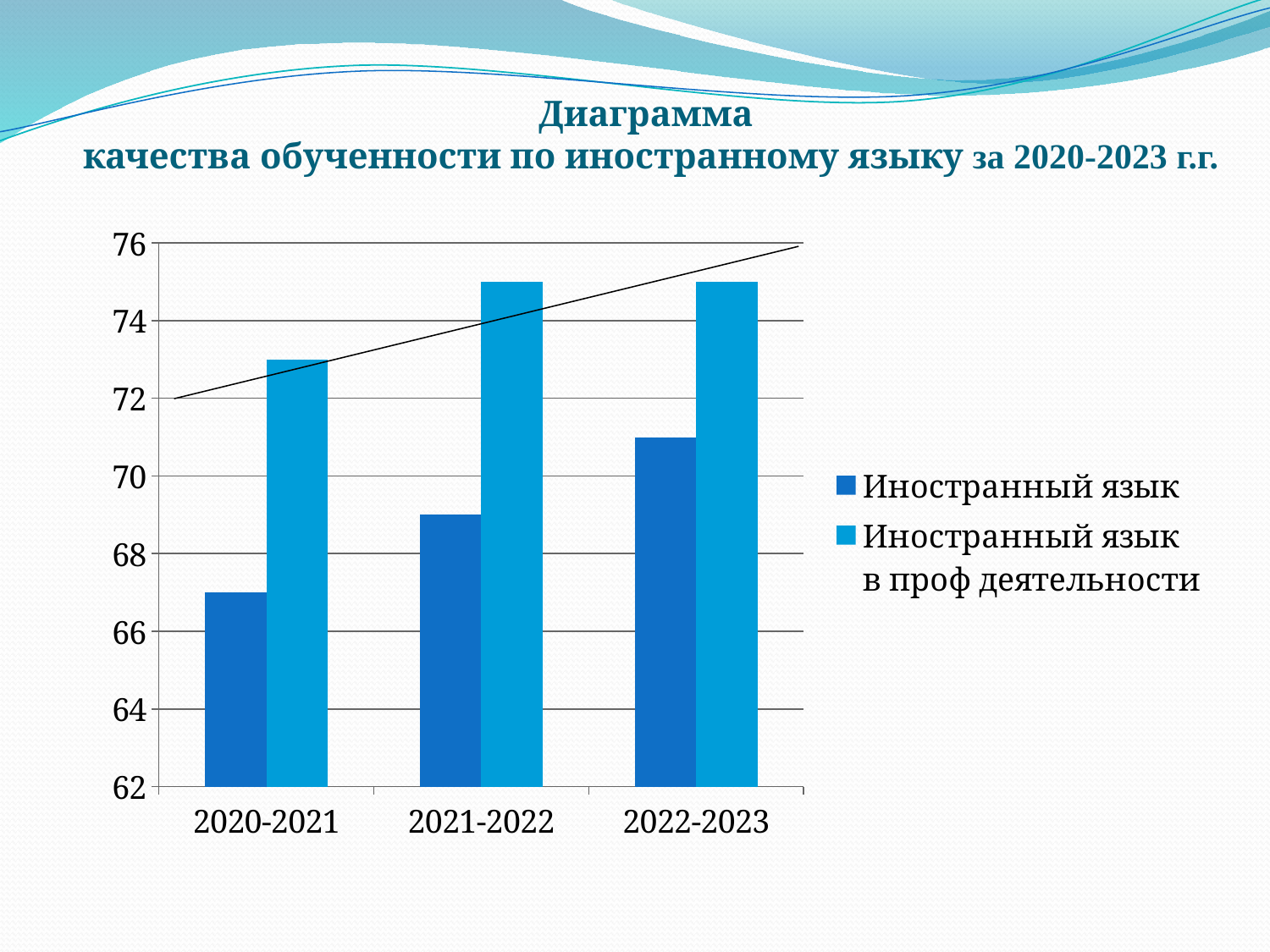
Is the value for Иностранный язык в проф деятельности in 2021-2022 greater or less than 74? greater What kind of chart is shown on the slide? bar chart Is the value for Иностранный язык in 2020-2021 greater or less than 68? less In which academic year is the value for Иностранный язык the lowest? 2020-2021 Which series is shown in the darker blue colour? Иностранный язык Which is larger in 2021-2022: Иностранный язык or Иностранный язык в проф деятельности? Иностранный язык в проф деятельности Is the value for Иностранный язык in 2022-2023 greater or less than 70? greater How many academic-year categories are shown on the x axis? 3 How many series does the legend list? 2 Do the values for Иностранный язык rise or fall from 2020-2021 to 2022-2023? rise